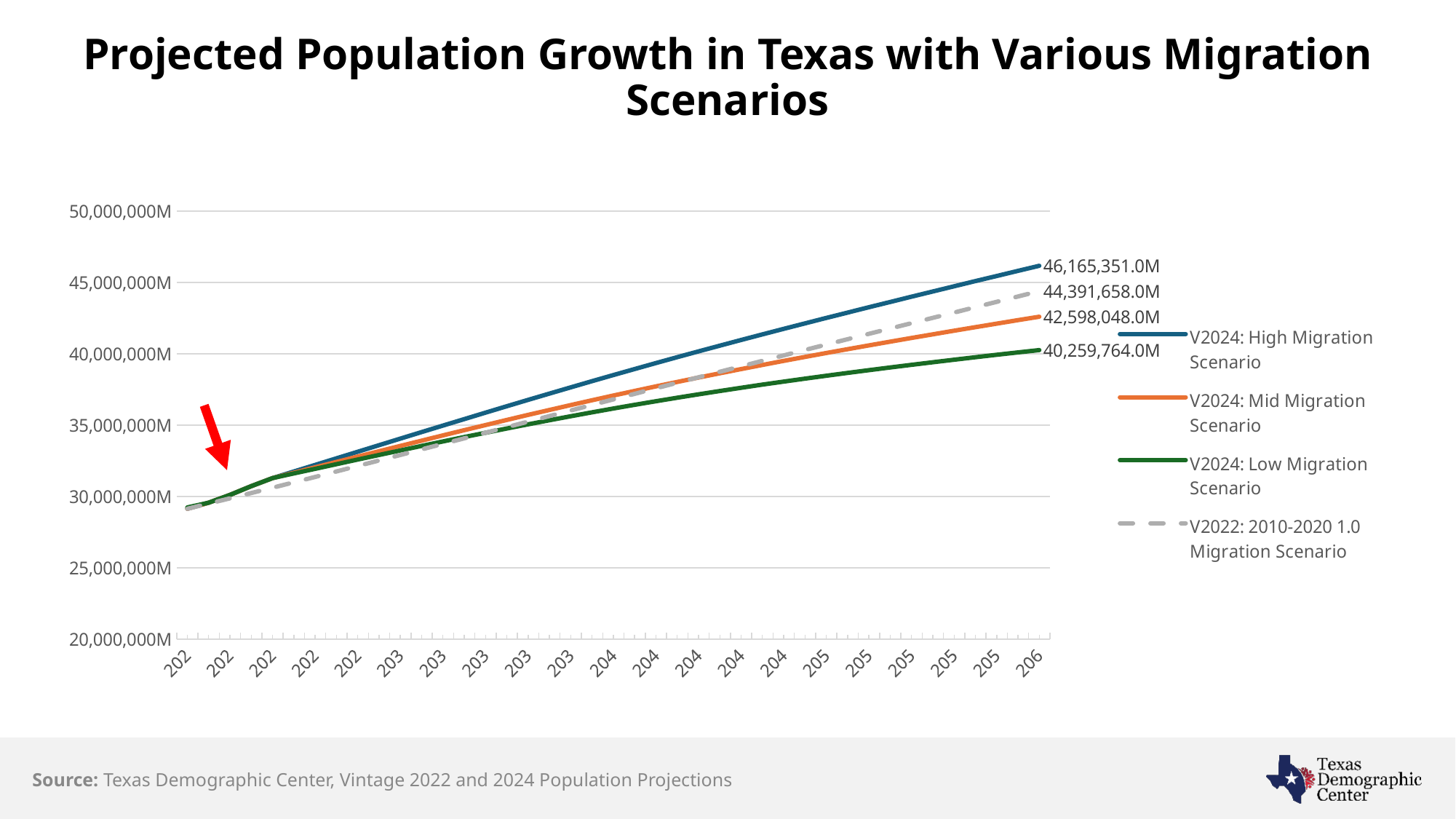
Which series ends at the highest value? V2024: High Migration Scenario What is the final labelled value for the V2024: High Migration Scenario series? 46,165,351.0M Which ends higher: the V2024: Mid Migration Scenario or the V2022: 2010-2020 1.0 Migration Scenario? V2022: 2010-2020 1.0 Migration Scenario Which series ends at the lowest value? V2024: Low Migration Scenario Is the final value of the V2024: Low Migration Scenario greater or less than 45,000,000M? less What is the final labelled value for the V2024: Low Migration Scenario series? 40,259,764.0M What is the final labelled value for the V2022: 2010-2020 1.0 Migration Scenario series? 44,391,658.0M What kind of chart is shown on the slide? line chart What is the final labelled value for the V2024: Mid Migration Scenario series? 42,598,048.0M What is the difference between the final values of the V2024: High Migration Scenario and the V2024: Low Migration Scenario? 5,905,587.0M Do the series values rise or fall along the x axis? rise How many series does the legend list? 4